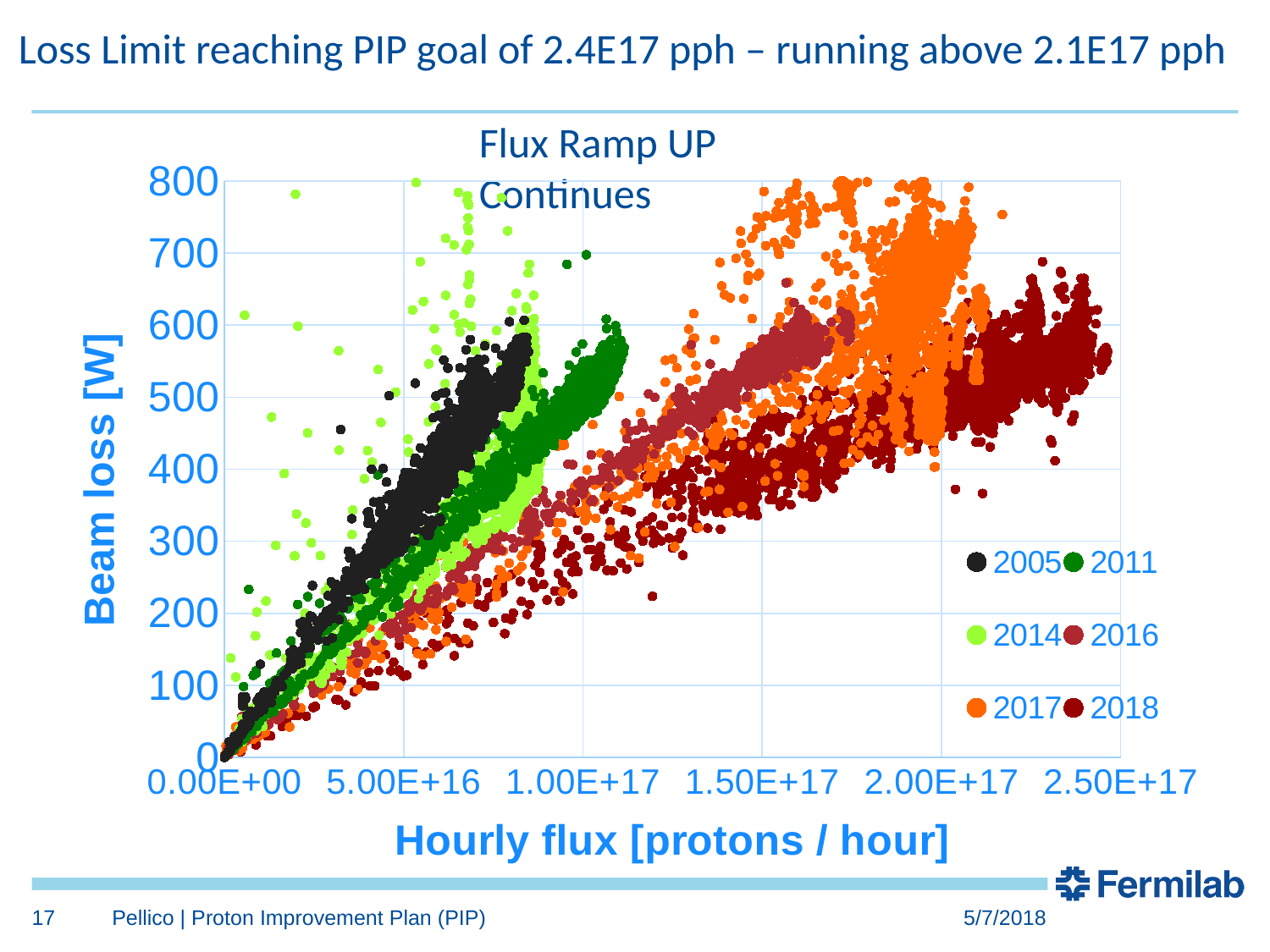
Which series reaches the highest hourly flux on the x axis? 2018 What is the label of the x axis? Hourly flux [protons / hour] Does beam loss generally rise or fall as hourly flux increases along the x axis? rise Is the maximum hourly flux reached by the 2005 series greater or less than 1.00E+17? less How many series does the legend list? 6 What is the highest value shown on the y axis? 800 What is the highest tick value shown on the x axis? 2.50E+17 What kind of chart is shown on the slide? scatter chart Which series reaches a higher hourly flux, 2005 or 2017? 2017 Is the maximum hourly flux reached by the 2018 series greater or less than 2.00E+17? greater